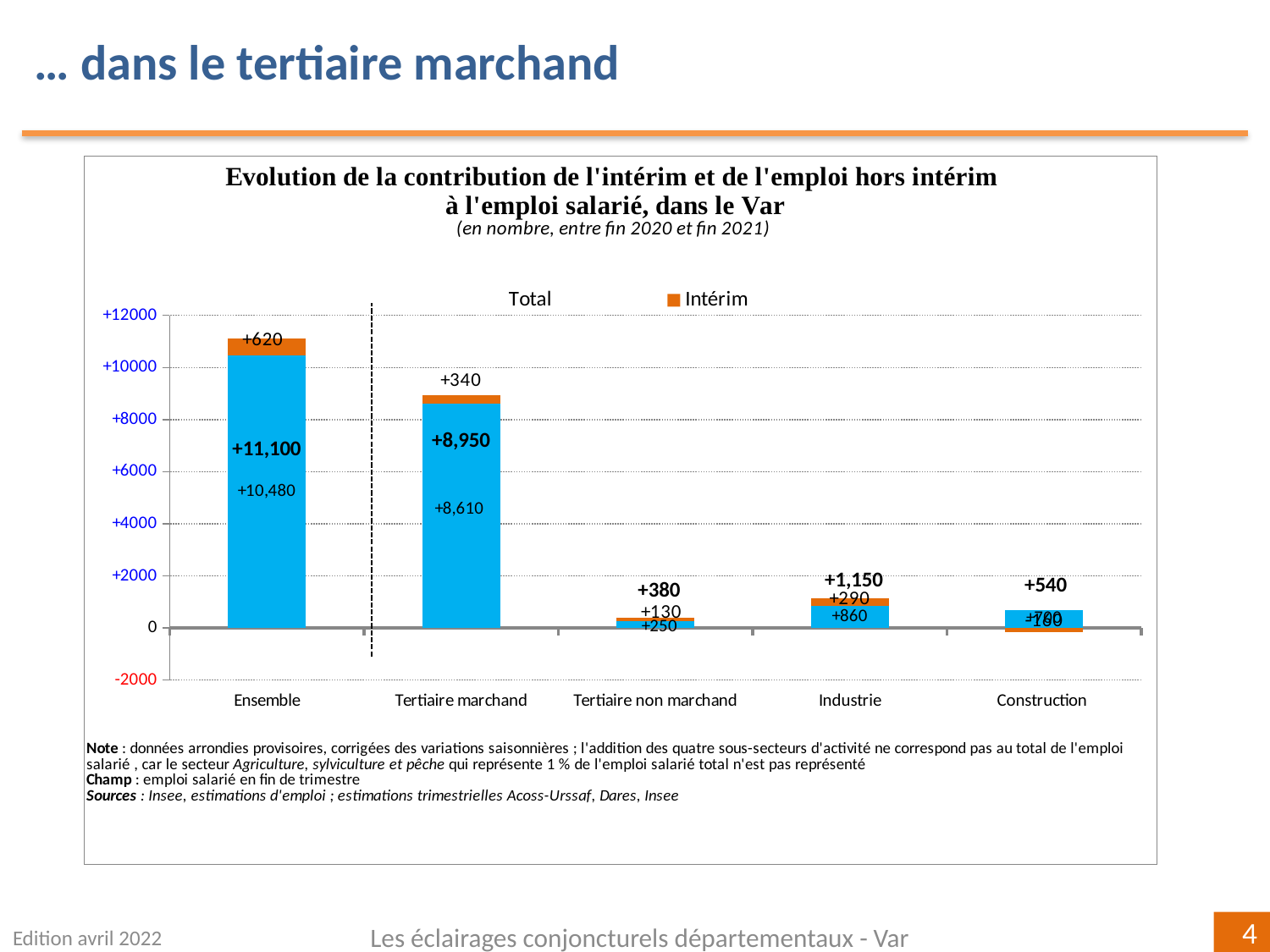
What kind of chart is shown on the slide? bar chart Which series is shown in orange according to the legend? Intérim Is the total value for Tertiaire marchand greater or less than 8000? greater Which category has the lowest total value? Tertiaire non marchand What is the total value shown for Ensemble? +11,100 What is the Intérim value for Ensemble? +620 What is the Intérim value for Tertiaire marchand? +340 What is the difference between the total for Ensemble and the total for Tertiaire marchand? 2,150 Which has the larger total value, Industrie or Construction? Industrie How many sector categories are shown on the x axis? 5 What is the total value shown for Industrie? +1,150 Which category has the highest total value? Ensemble